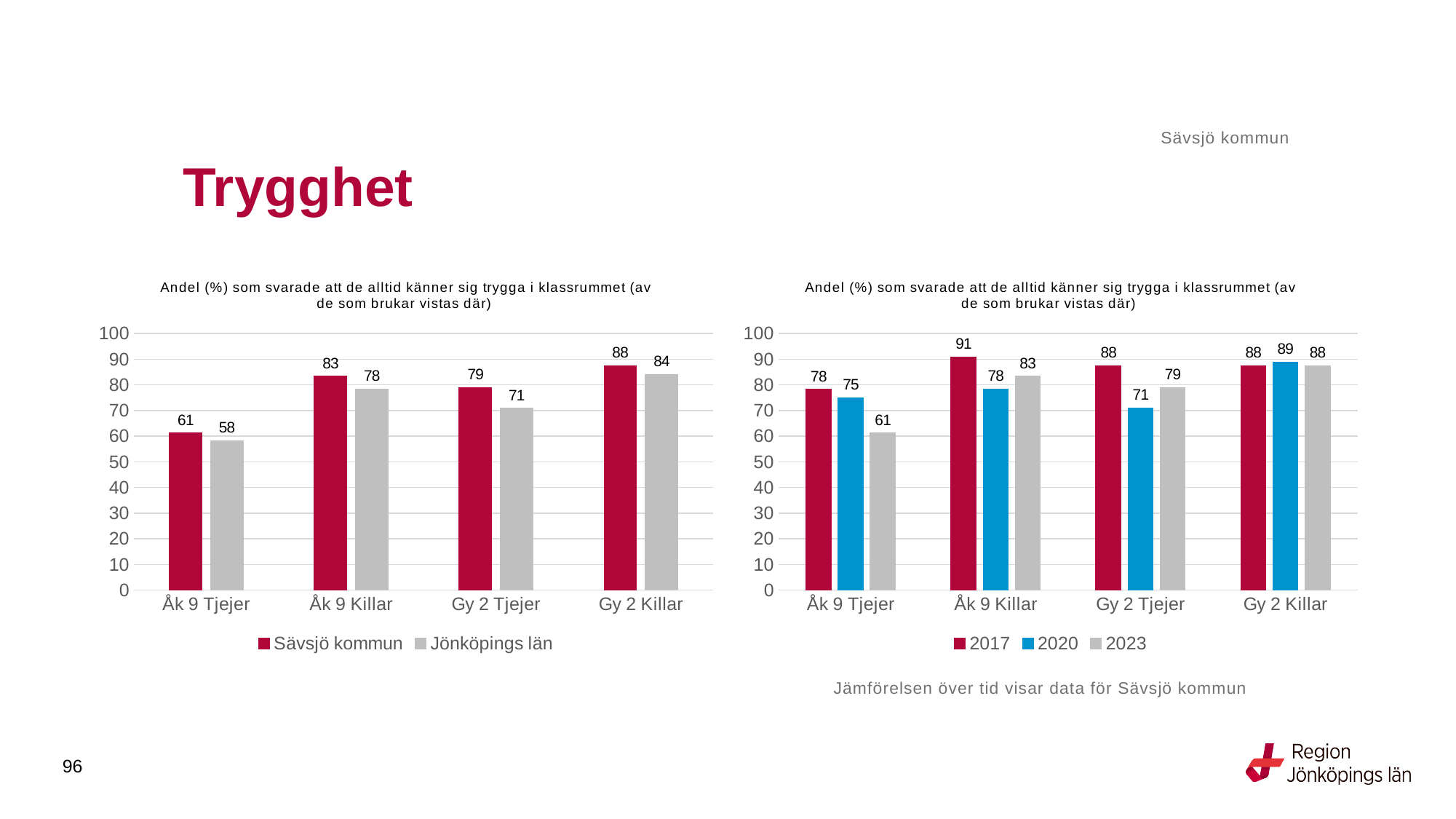
In the right chart, is the value for 2017 or 2023 larger for Åk 9 Killar? 2017 In the left chart, what is the value for Sävsjö kommun for Åk 9 Tjejer? 61 In the right chart, what is the value for 2023 for Åk 9 Tjejer? 61 In the left chart, what is the value for Jönköpings län for Gy 2 Tjejer? 71 In the right chart, what is the value for 2020 for Gy 2 Tjejer? 71 In the left chart, which category has the lowest value for Jönköpings län? Åk 9 Tjejer What kind of chart is the right chart? Bar chart In the left chart, how many series does the legend list? 2 In the right chart, how many categories are shown on the x axis? 4 In the right chart, which category has the highest value for 2017? Åk 9 Killar In the left chart, what is the difference between Sävsjö kommun and Jönköpings län for Gy 2 Tjejer? 8 In the left chart, which category has the highest value for Sävsjö kommun? Gy 2 Killar